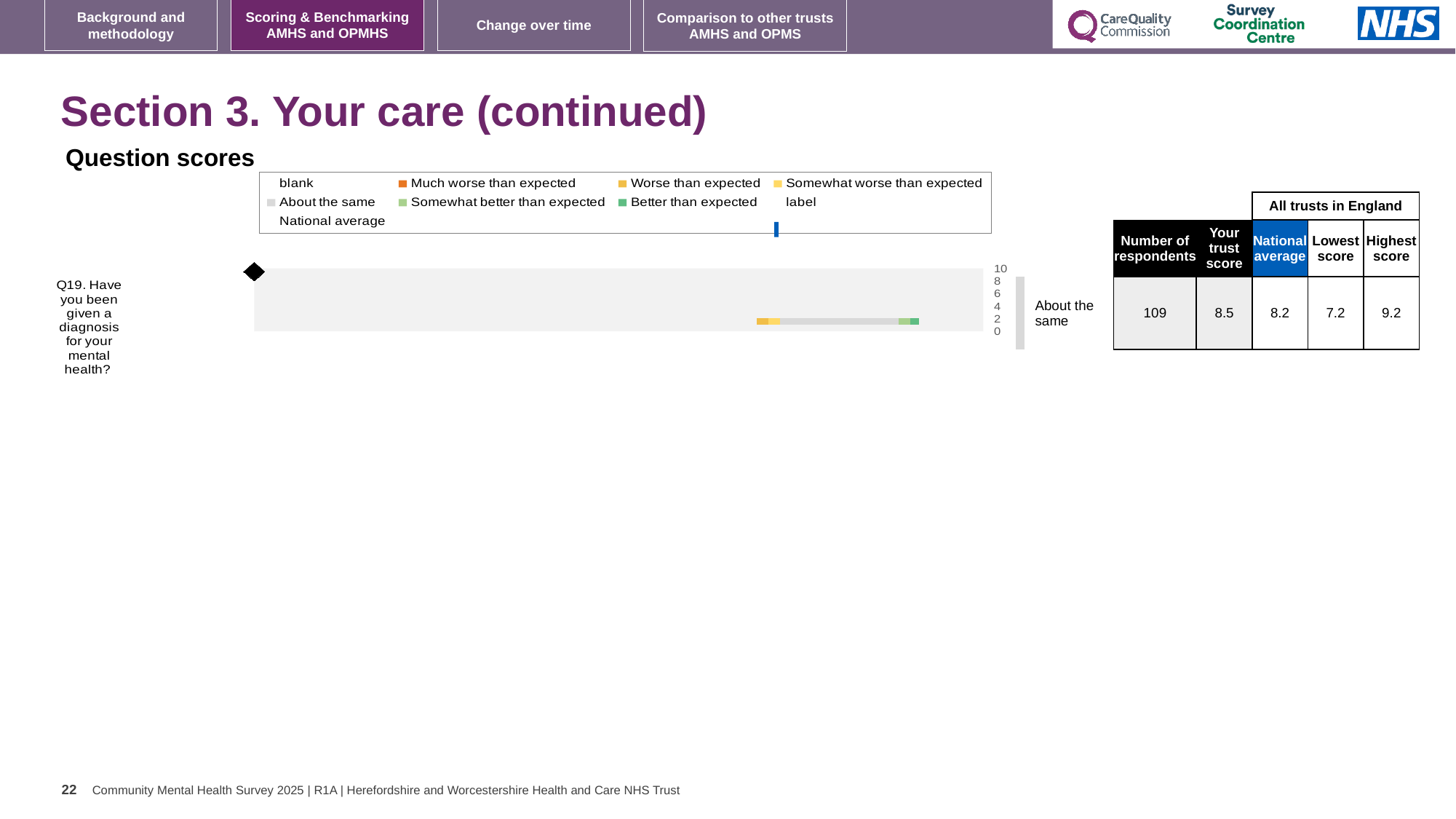
How many questions are plotted in the 'Question scores' chart? 1 Which question is plotted in the 'Question scores' chart? Q19. Have you been given a diagnosis for your mental health? What is the difference between the trust's score and the national average for Q19? 0.3 What is the difference between the highest and lowest scores among all trusts in England for Q19? 2.0 Which is larger for Q19: the trust's score or the national average? the trust's score What is the national average score for Q19? 8.2 What is the highest score among all trusts in England for Q19? 9.2 What is the trust's score for Q19? 8.5 What is the lowest score among all trusts in England for Q19? 7.2 How many respondents answered Q19? 109 What benchmark category label is shown next to the bar for Q19? About the same What kind of chart is shown under 'Question scores'? bar chart